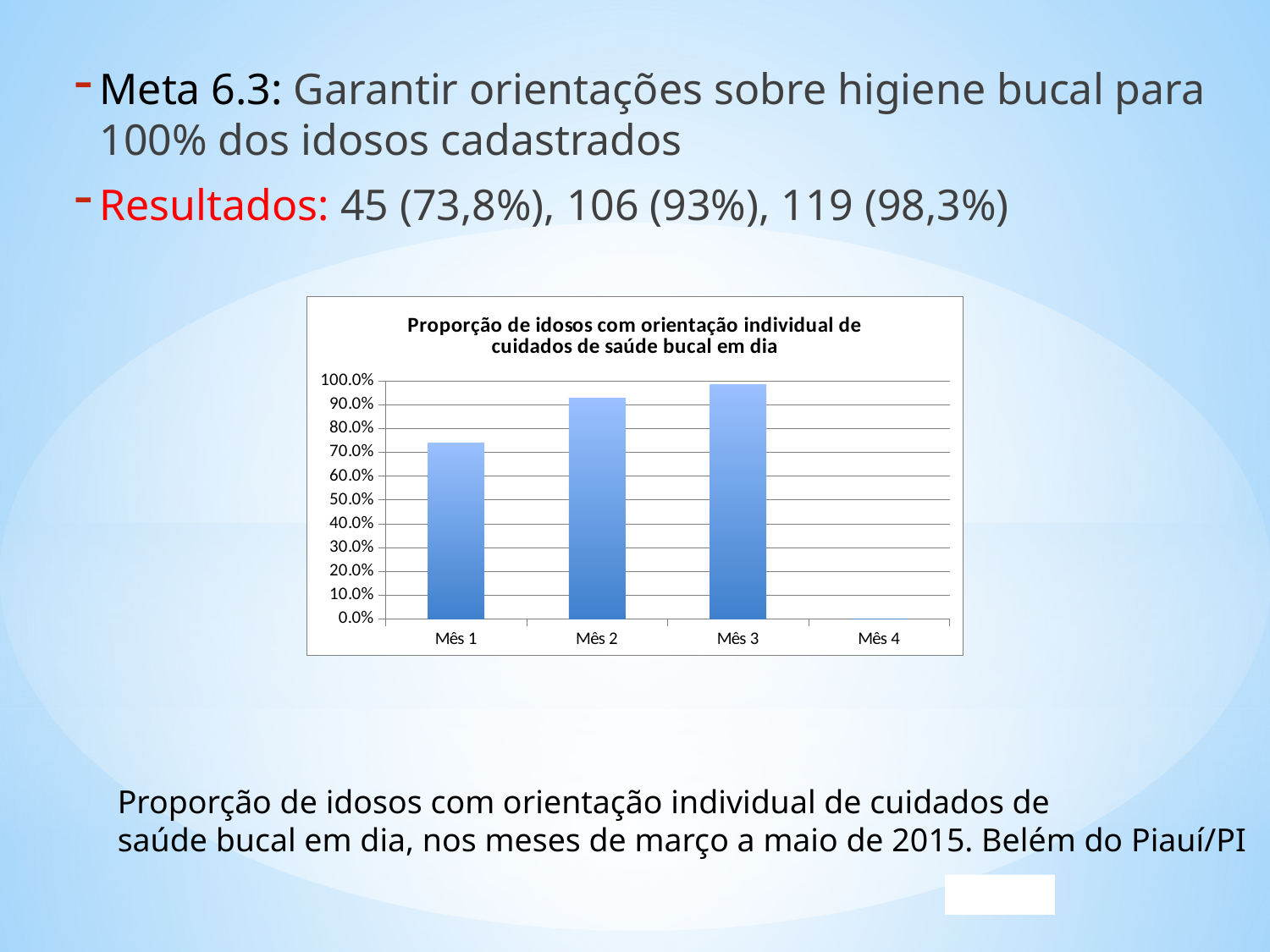
Among the months with a plotted bar, which has the lowest value? Mês 1 Which is larger, the value for Mês 1 or the value for Mês 2? Mês 2 How many bars are plotted in the chart? 3 Is the value for Mês 1 greater or less than 80.0%? less Which month has the highest bar in the chart? Mês 3 What kind of chart is shown on the slide? bar chart Is the value for Mês 2 greater or less than 90.0%? greater Which category on the x axis has no bar plotted? Mês 4 What is the title of the chart? Proporção de idosos com orientação individual de cuidados de saúde bucal em dia Is the value for Mês 3 greater or less than 90.0%? greater Do the values rise or fall from Mês 1 to Mês 3? rise How many categories are shown on the x axis of the chart? 4